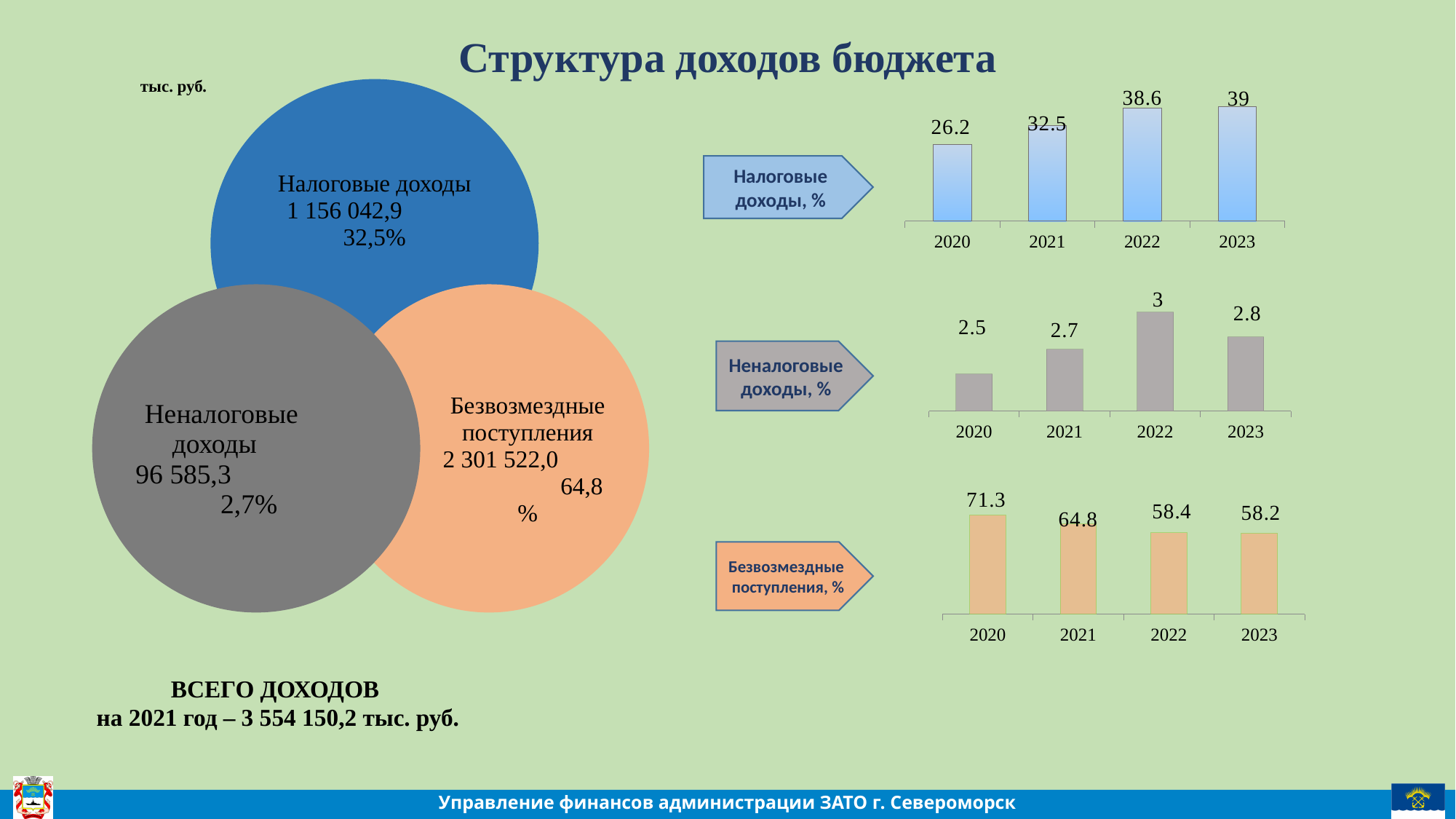
In the 'Неналоговые доходы, %' chart, which is larger, the value for 2021 or the value for 2023? 2023 How many years are shown on the x axis of the 'Безвозмездные поступления, %' chart? 4 In the 'Безвозмездные поступления, %' chart, what is the difference between the 2020 and 2023 values? 13.1 In the 'Неналоговые доходы, %' chart, which year has the lowest value? 2020 In the 'Налоговые доходы, %' chart, which year has the highest value? 2023 In the 'Налоговые доходы, %' chart, do the values rise or fall from 2020 to 2023? rise What type of chart is the 'Неналоговые доходы, %' chart? bar chart In the 'Безвозмездные поступления, %' chart, which year has the highest value? 2020 In the 'Безвозмездные поступления, %' chart, what is the value for 2021? 64.8 In the 'Налоговые доходы, %' chart, what is the difference between the 2022 and 2020 values? 12.4 In the 'Налоговые доходы, %' chart, what is the value for 2020? 26.2 In the 'Неналоговые доходы, %' chart, what is the value for 2022? 3